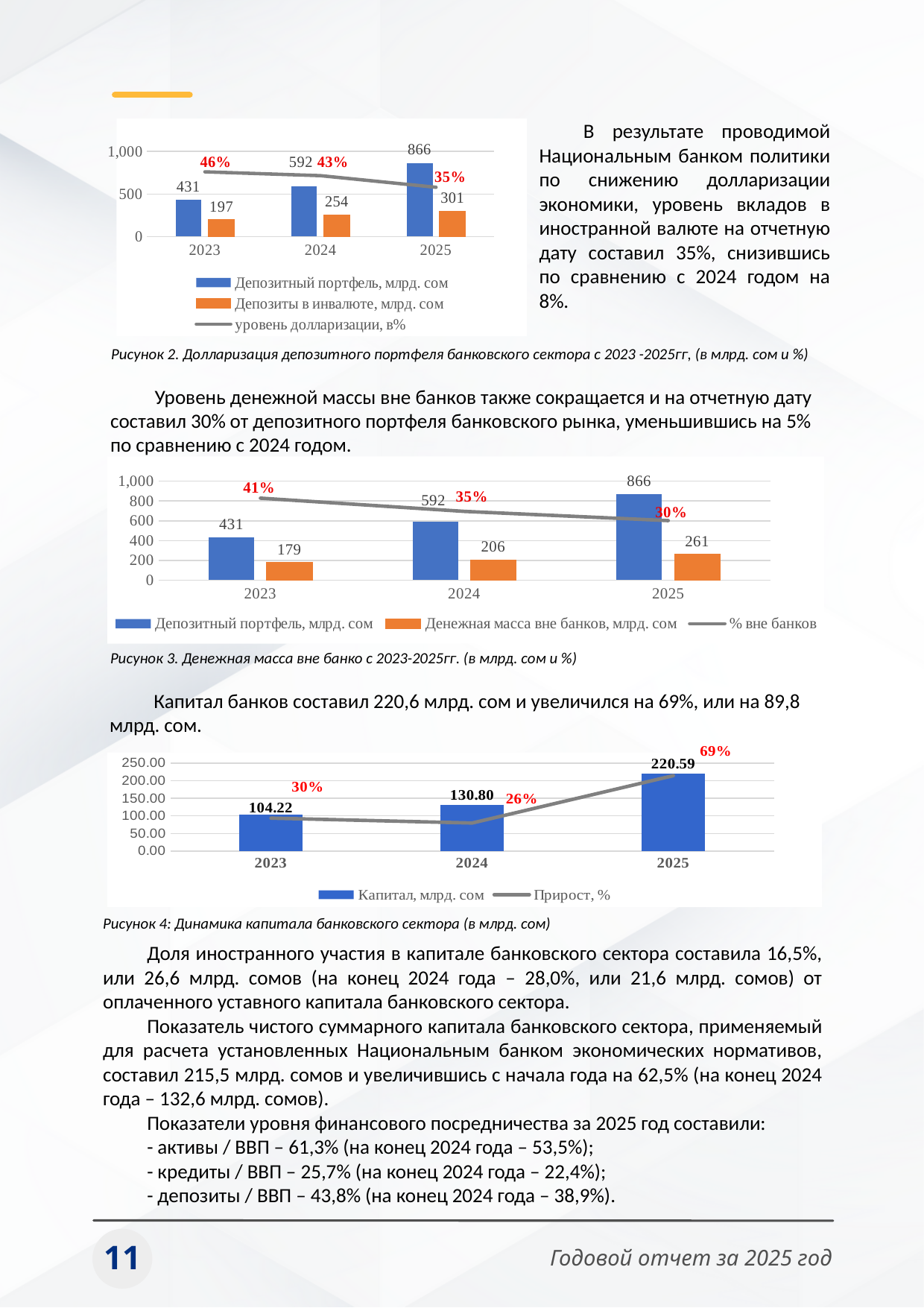
In the top chart (Рисунок 2), what is the value of 'Депозиты в инвалюте, млрд. сом' for 2024? 254 How many series does the legend of the top chart (Рисунок 2) list? 3 In the top chart (Рисунок 2), what is the 'уровень долларизации, в%' value for 2025? 35% In the top chart (Рисунок 2), does the dollarization level rise or fall from 2023 to 2025? fall In the middle chart (Рисунок 3), what is the value of 'Денежная масса вне банков, млрд. сом' for 2023? 179 What type of chart is the bottom chart (Рисунок 4)? Combined bar and line chart In the top chart (Рисунок 2), what is the difference between the deposit portfolio and foreign-currency deposits in 2025? 565 In the middle chart (Рисунок 3), what is the '% вне банков' value for 2024? 35% In the bottom chart (Рисунок 4), which year has the lowest 'Прирост, %' value? 2024 In the middle chart (Рисунок 3), what is the difference between money outside banks in 2025 and in 2024? 55 In the middle chart (Рисунок 3), which year has the highest deposit portfolio? 2025 In the bottom chart (Рисунок 4), what is the value of 'Капитал, млрд. сом' for 2024? 130.80